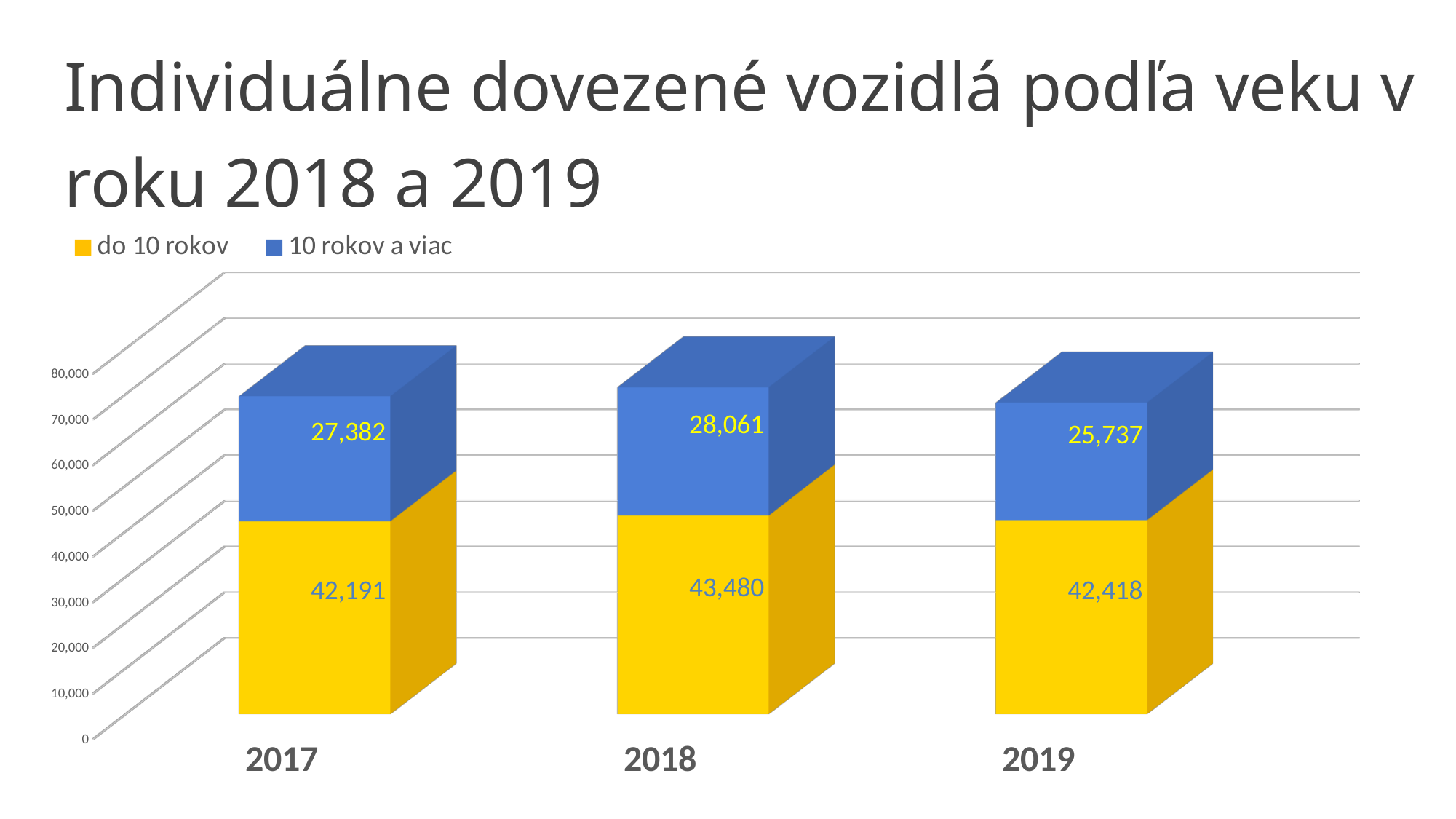
What is the difference between the "10 rokov a viac" values for 2018 and 2019? 2,324 What is the value for "10 rokov a viac" in 2019? 25,737 How many series does the legend list? 2 Which year has the lowest value for "10 rokov a viac"? 2019 Which year has the highest value for "do 10 rokov"? 2018 What is the difference between the "do 10 rokov" values for 2018 and 2017? 1,289 What is the value for "10 rokov a viac" in 2017? 27,382 How many years are shown on the x axis? 3 What is the value for "do 10 rokov" in 2018? 43,480 Which is larger: the "do 10 rokov" value in 2019 or in 2017? 2019 What kind of chart is shown on the slide? Stacked bar chart What is the total of the stacked bar for 2018? 71,541